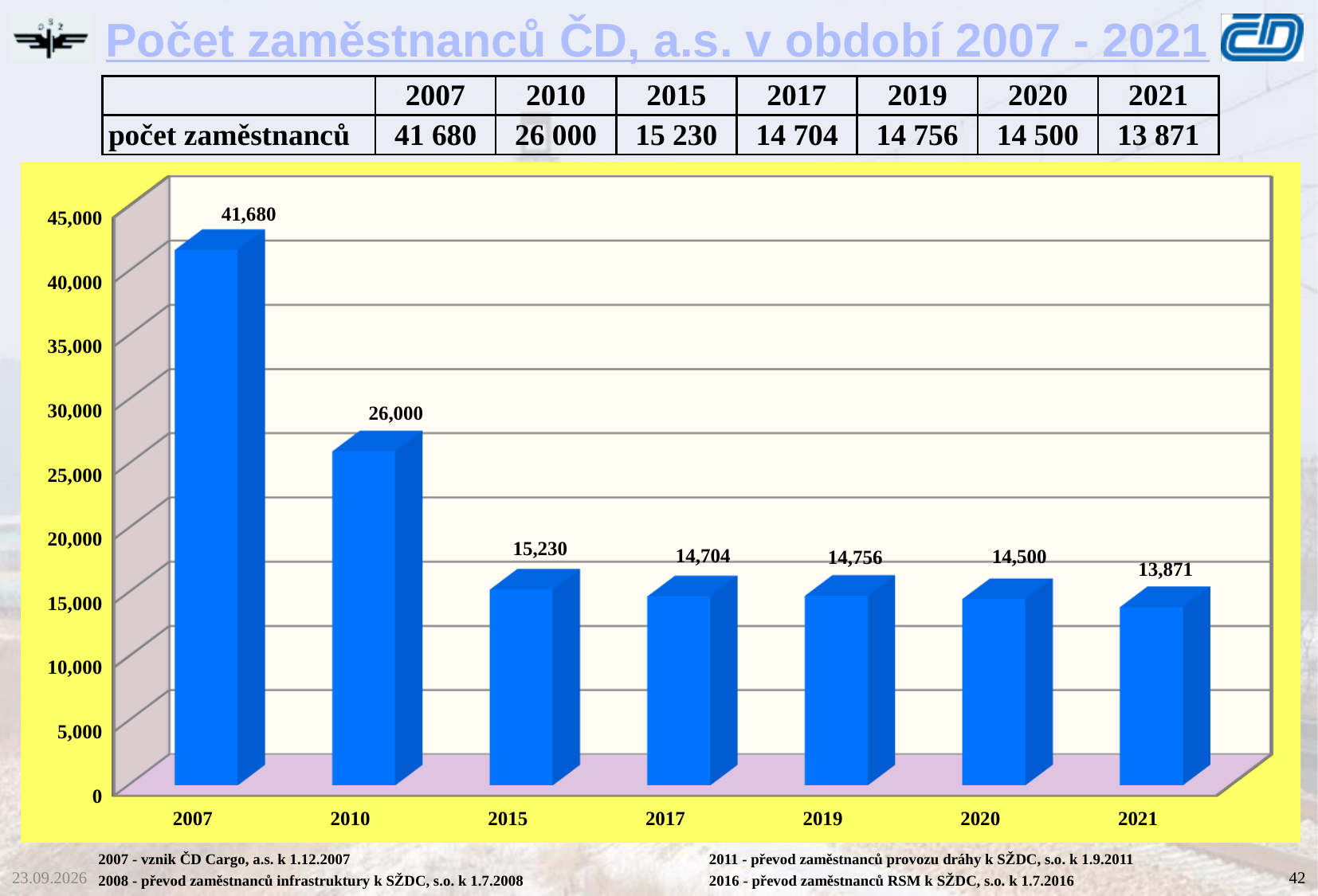
By how much does the value for 2019 exceed the value for 2017? 52 What is the number of employees shown for 2007? 41,680 What is the value for 2021? 13,871 What is the difference between the values for 2007 and 2010? 15,680 Is the value for 2021 greater or less than 15,000? less What value does the bar for 2015 show? 15,230 Which year has the highest number of employees? 2007 Which is larger, the value for 2010 or the value for 2015? 2010 Which year has the lowest number of employees? 2021 How many years are shown on the x axis of the chart? 7 Do the values generally rise or fall from 2007 to 2021? fall What kind of chart is shown on the slide? bar chart